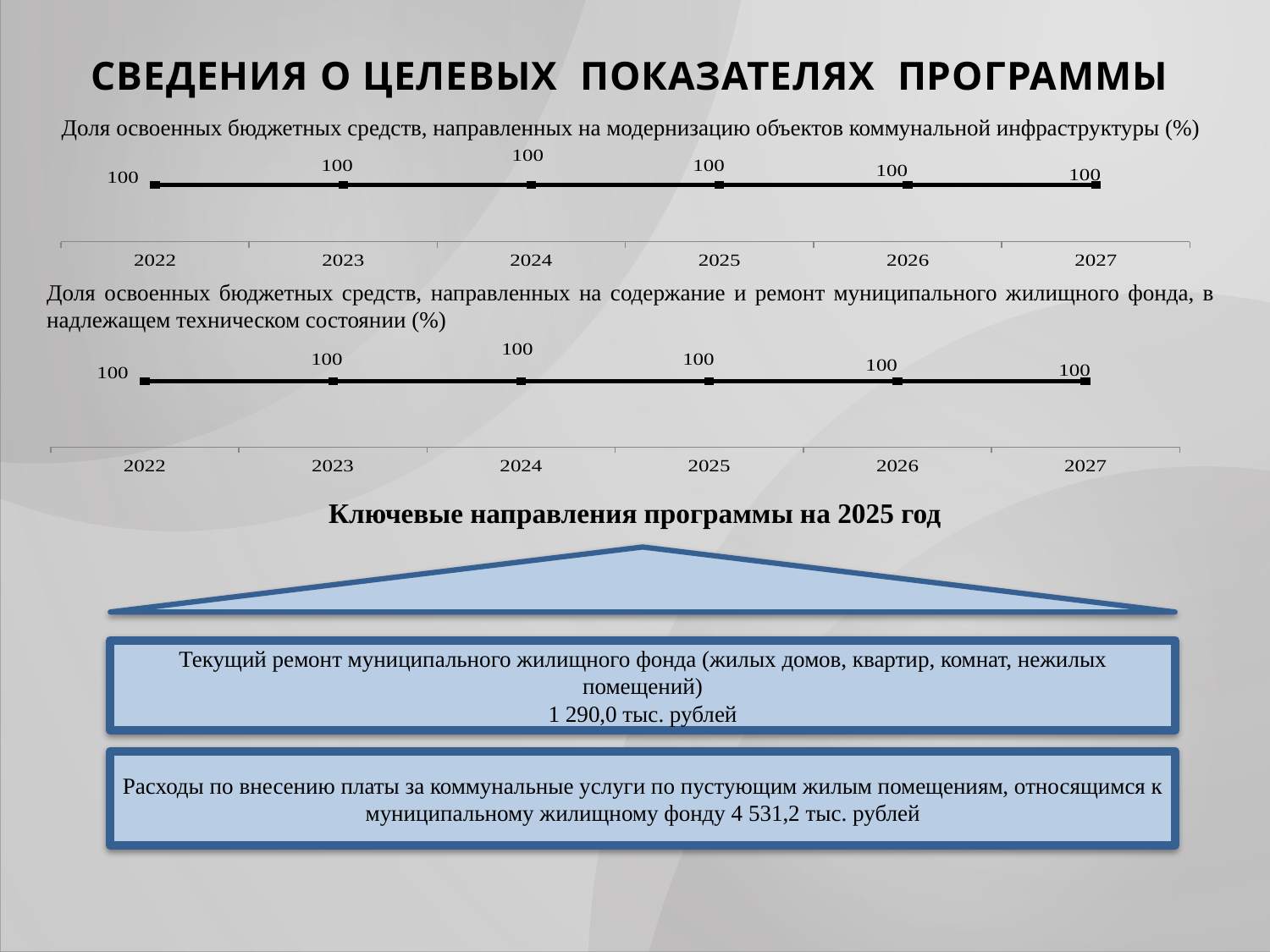
What kind of chart is the second chart on the slide? Line chart What is the first year shown on the x axis of the second chart? 2022 How many years are plotted on the x axis of the top chart? 6 In the top chart (share of budget funds for modernisation of communal infrastructure), what is the value for 2022? 100 In the second chart (share of budget funds for maintenance and repair of municipal housing stock), what is the value for 2023? 100 What kind of chart is the top chart on the slide? Line chart In the top chart, do the values rise, fall or stay flat from 2022 to 2027? Stay flat In the second chart (share of budget funds for maintenance and repair of municipal housing stock), what is the value for 2025? 100 In the second chart, do the values rise, fall or stay flat from 2022 to 2027? Stay flat How many data points does the second chart (maintenance and repair of municipal housing stock) show? 6 In the top chart (share of budget funds for modernisation of communal infrastructure), what is the value for 2027? 100 In the top chart, what is the difference between the values for 2027 and 2022? 0